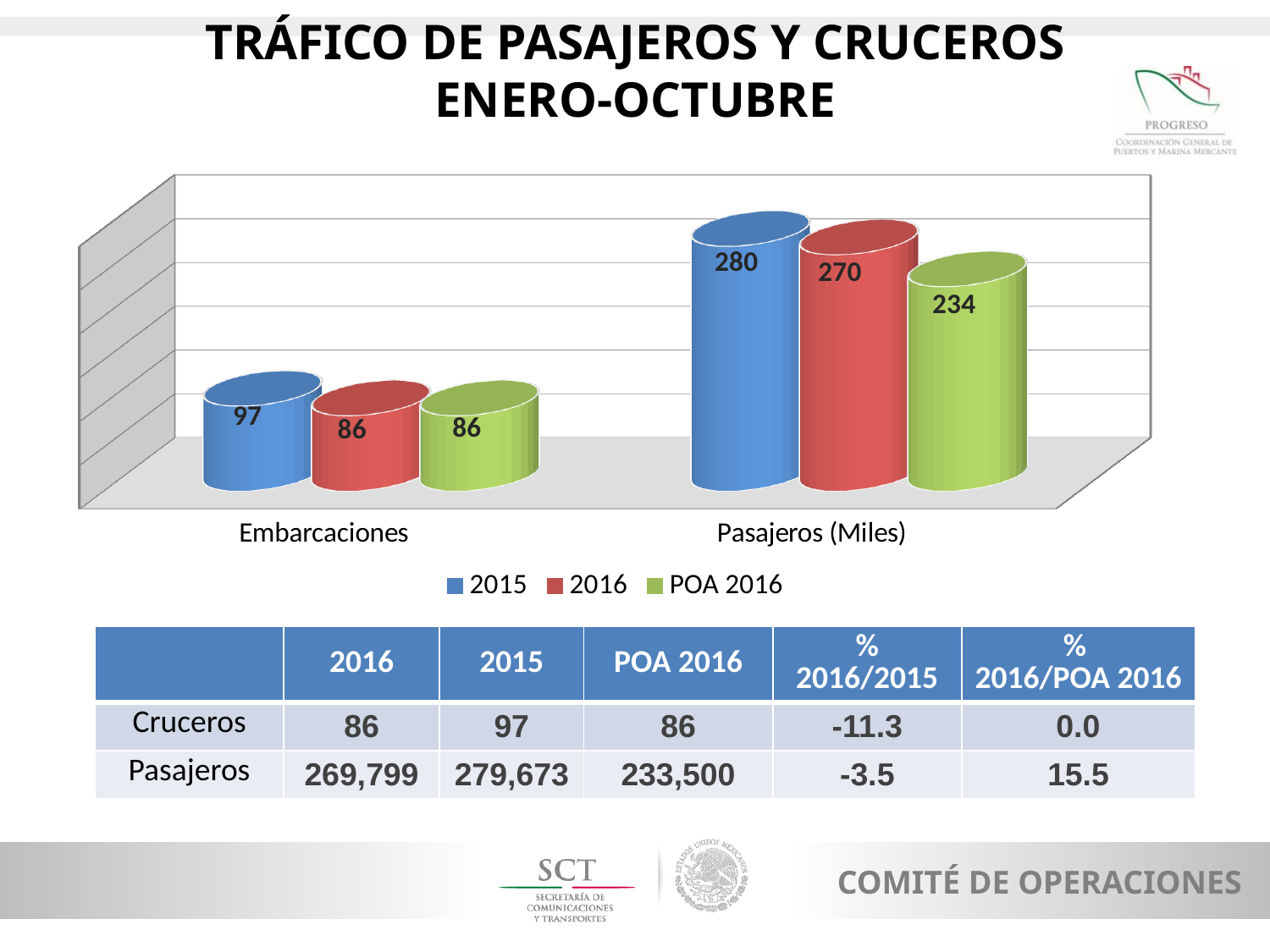
Which series has the highest value in the Pasajeros (Miles) category? 2015 What is the value for 2015 in the Embarcaciones category? 97 Which is larger for Pasajeros (Miles): the 2015 value or the POA 2016 value? 2015 What is the difference between the 2016 and POA 2016 values for Pasajeros (Miles)? 36 Which colour represents the POA 2016 series in the chart? green How many categories are shown on the x axis of the chart? 2 Which series has the lowest value in the Pasajeros (Miles) category? POA 2016 What is the value for POA 2016 in the Pasajeros (Miles) category? 234 What is the difference between the 2015 and 2016 values for Embarcaciones? 11 What is the value for 2016 in the Pasajeros (Miles) category? 270 How many series does the chart legend list? 3 What kind of chart is shown on the slide? bar chart